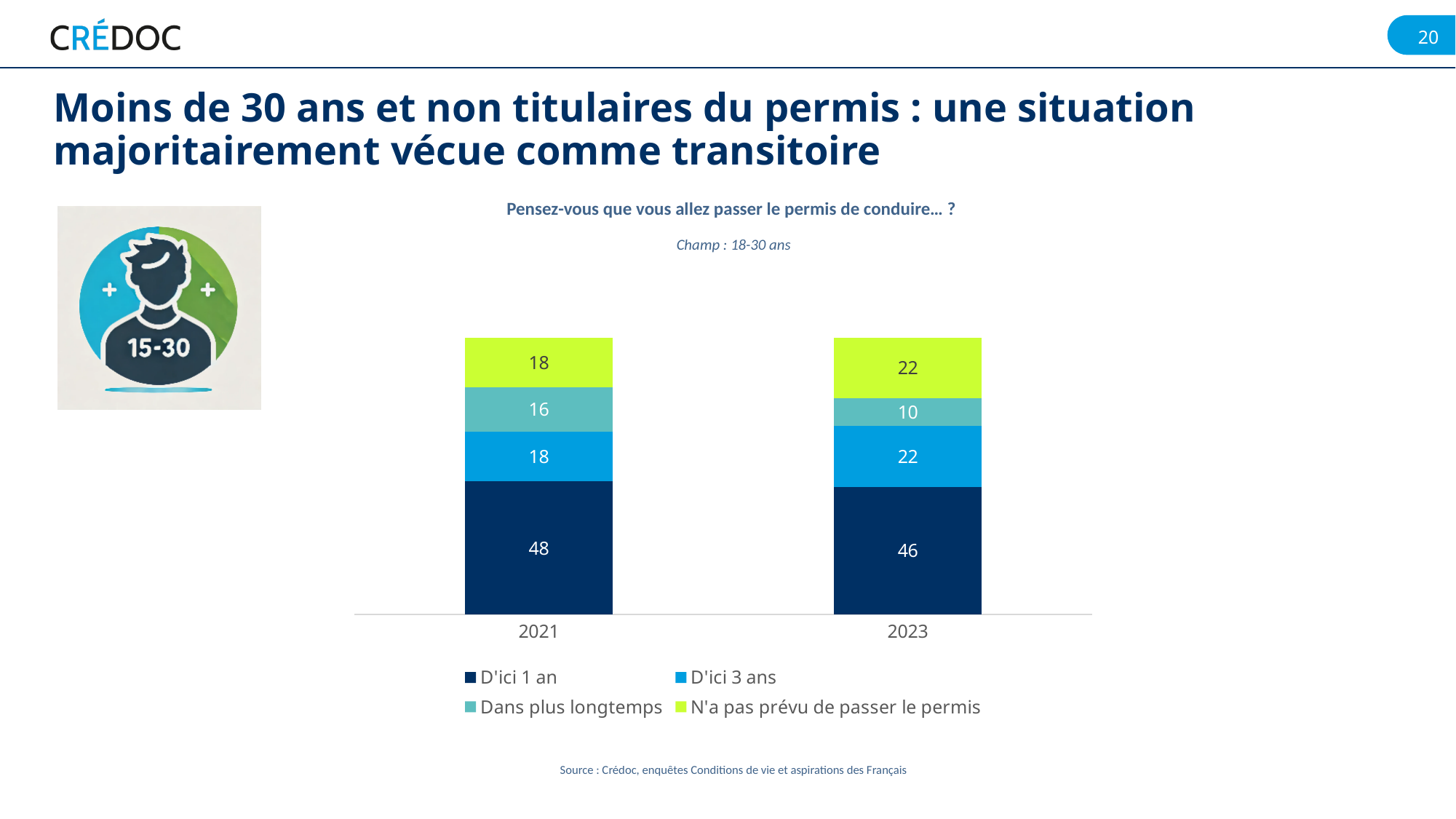
What is the total of the stacked bar for 2021? 100 What is the value for "D'ici 3 ans" in 2021? 18 What is the value for "Dans plus longtemps" in 2023? 10 Is the value for "D'ici 3 ans" larger in 2021 or in 2023? 2023 What is the value for "N'a pas prévu de passer le permis" in 2023? 22 How many categories are shown on the x axis? 2 What kind of chart is shown on the slide? Stacked bar chart Which series has the highest value in 2023? D'ici 1 an Which series has the lowest value in 2023? Dans plus longtemps What is the value for "D'ici 1 an" in 2021? 48 What is the difference between the "Dans plus longtemps" values for 2021 and 2023? 6 How many series does the legend list? 4